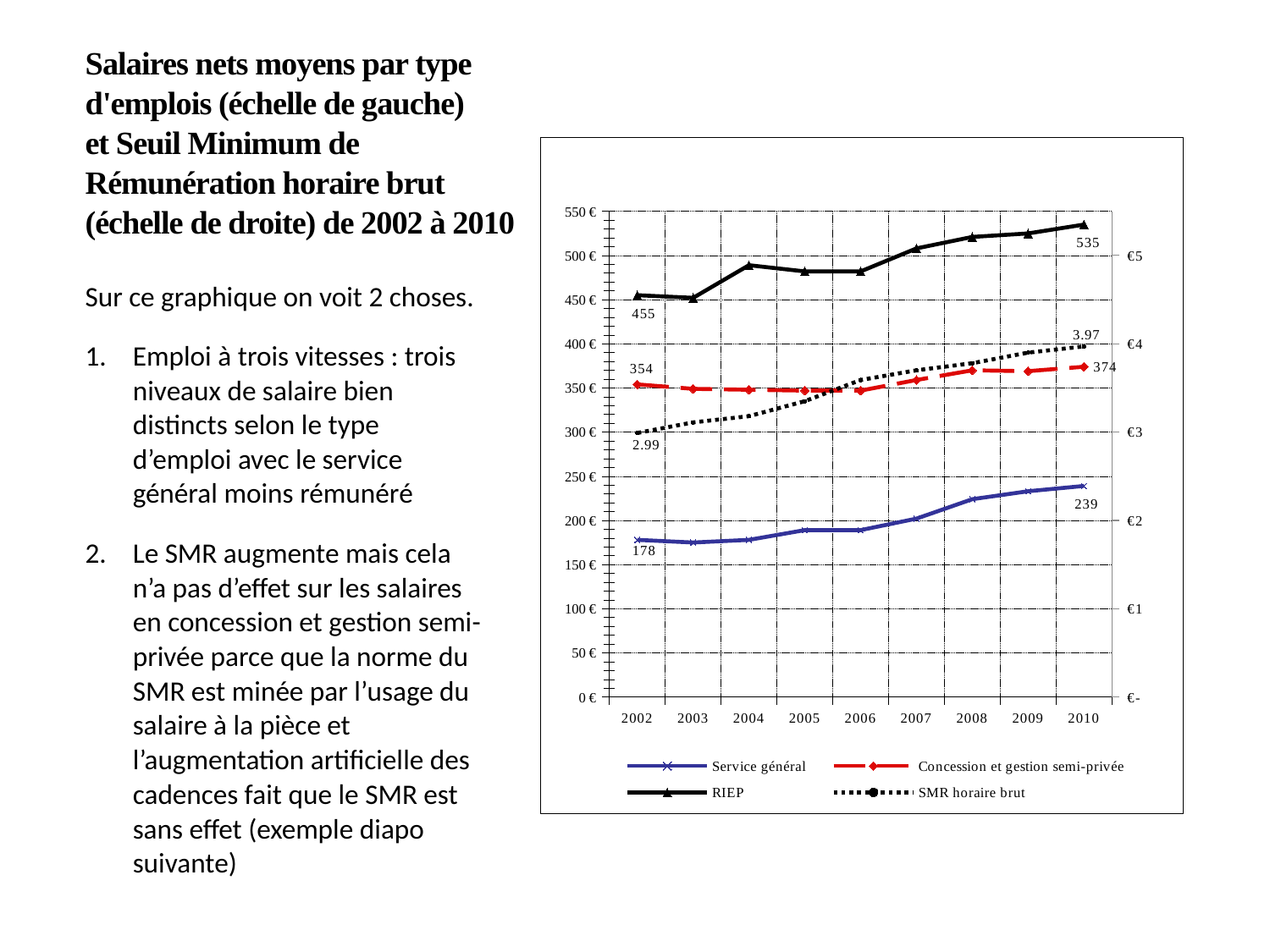
What kind of chart is shown on the slide? line chart How many years are plotted along the x axis of the chart? 9 What is the value for RIEP in 2010? 535 Which series has the highest values on the left-hand scale throughout the chart? RIEP By how much did the Service général value increase from 2002 to 2010? 61 By how much did the Concession et gestion semi-privée value change from 2002 (354) to 2010 (374)? 20 What is the value for Service général in 2002? 178 How many series does the chart legend list? 4 Is the value for Service général in 2008 greater or less than 200 €? greater Does the Service général series rise or fall from 2002 to 2010? rise What is the value for SMR horaire brut in 2010? 3.97 What is the value for RIEP in 2002? 455